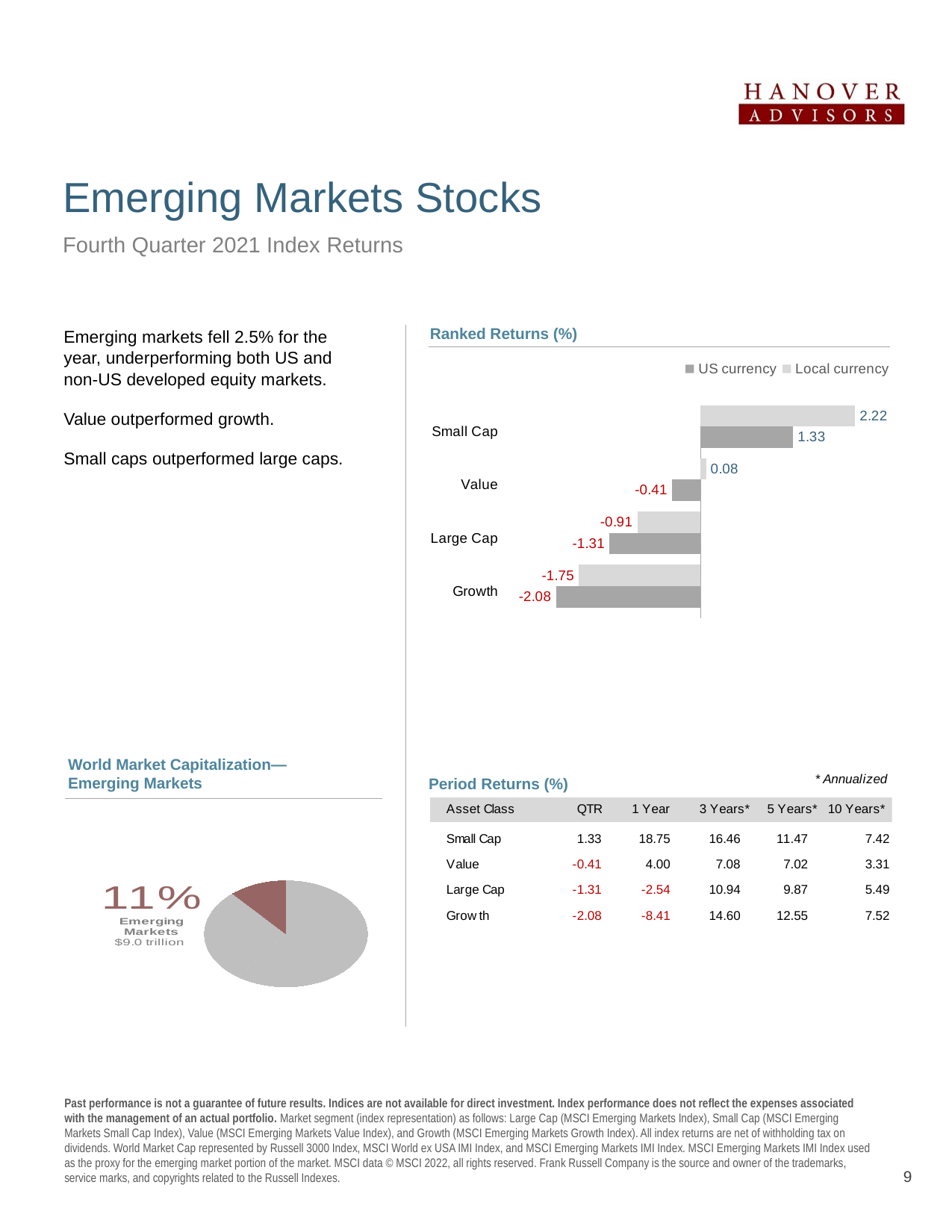
What kind of chart is the Ranked Returns (%) chart? Bar chart In the Ranked Returns (%) chart, what is the difference between the Local currency and US currency values for Small Cap? 0.89 In the World Market Capitalization—Emerging Markets pie chart, what share of the pie does Emerging Markets represent? 11% How many series does the legend of the Ranked Returns (%) chart list? 2 In the Ranked Returns (%) chart, what is the Local currency value for Growth? -1.75 How many categories are shown in the Ranked Returns (%) chart? 4 In the Ranked Returns (%) chart, what is the US currency value for Small Cap? 1.33 In the Ranked Returns (%) chart, what is the Local currency value for Value? 0.08 In the Ranked Returns (%) chart, which is larger for Large Cap: the US currency value or the Local currency value? Local currency In the Ranked Returns (%) chart, which category has the highest Local currency value? Small Cap In the Ranked Returns (%) chart, which category has the lowest US currency value? Growth In the Ranked Returns (%) chart, which series is shown in the darker gray colour? US currency